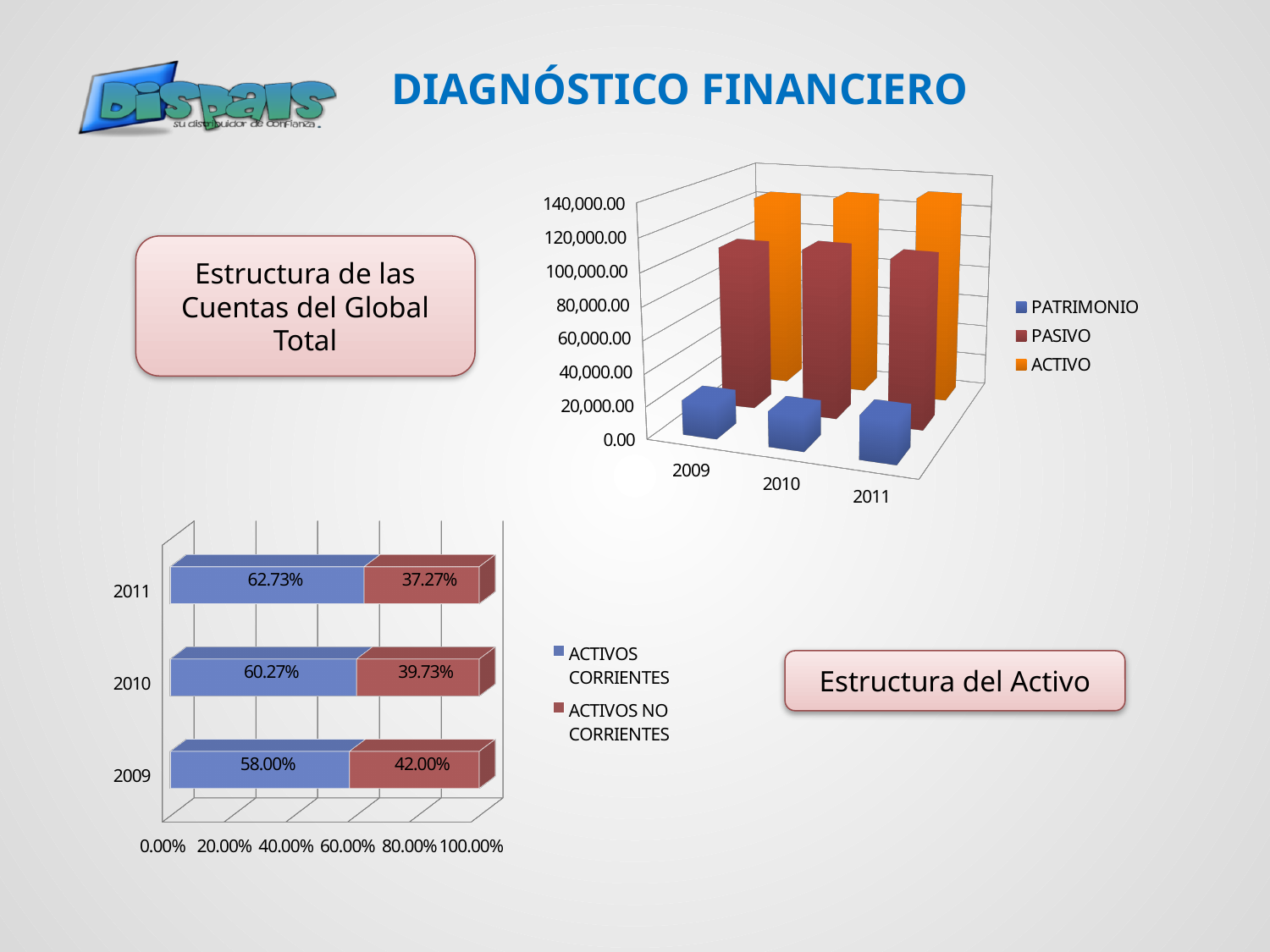
In the 'Estructura de las Cuentas del Global Total' chart at the top right, which series has the highest bars in every year? ACTIVO In the 'Estructura del Activo' chart at the bottom left, what is the value of ACTIVOS NO CORRIENTES for 2009? 42.00% In the 'Estructura de las Cuentas del Global Total' chart at the top right, how many years are shown on the x axis? 3 In the 'Estructura del Activo' chart at the bottom left, what is the value of ACTIVOS CORRIENTES for 2011? 62.73% In the 'Estructura del Activo' chart at the bottom left, is ACTIVOS CORRIENTES in 2010 larger or smaller than ACTIVOS NO CORRIENTES in 2010? larger In the 'Estructura del Activo' chart at the bottom left, which year has the lowest value for ACTIVOS NO CORRIENTES? 2011 In the 'Estructura del Activo' chart at the bottom left, how many series does the legend list? 2 In the 'Estructura del Activo' chart at the bottom left, which year has the highest value for ACTIVOS CORRIENTES? 2011 In the 'Estructura del Activo' chart at the bottom left, does the value of ACTIVOS CORRIENTES rise or fall from 2009 to 2011? rise In the 'Estructura de las Cuentas del Global Total' chart at the top right, is the value for PATRIMONIO in 2009 greater or less than 40,000.00? less In the 'Estructura del Activo' chart at the bottom left, what is the value of ACTIVOS NO CORRIENTES for 2010? 39.73% In the 'Estructura del Activo' chart at the bottom left, what is the difference between ACTIVOS CORRIENTES and ACTIVOS NO CORRIENTES in 2009? 16.00%